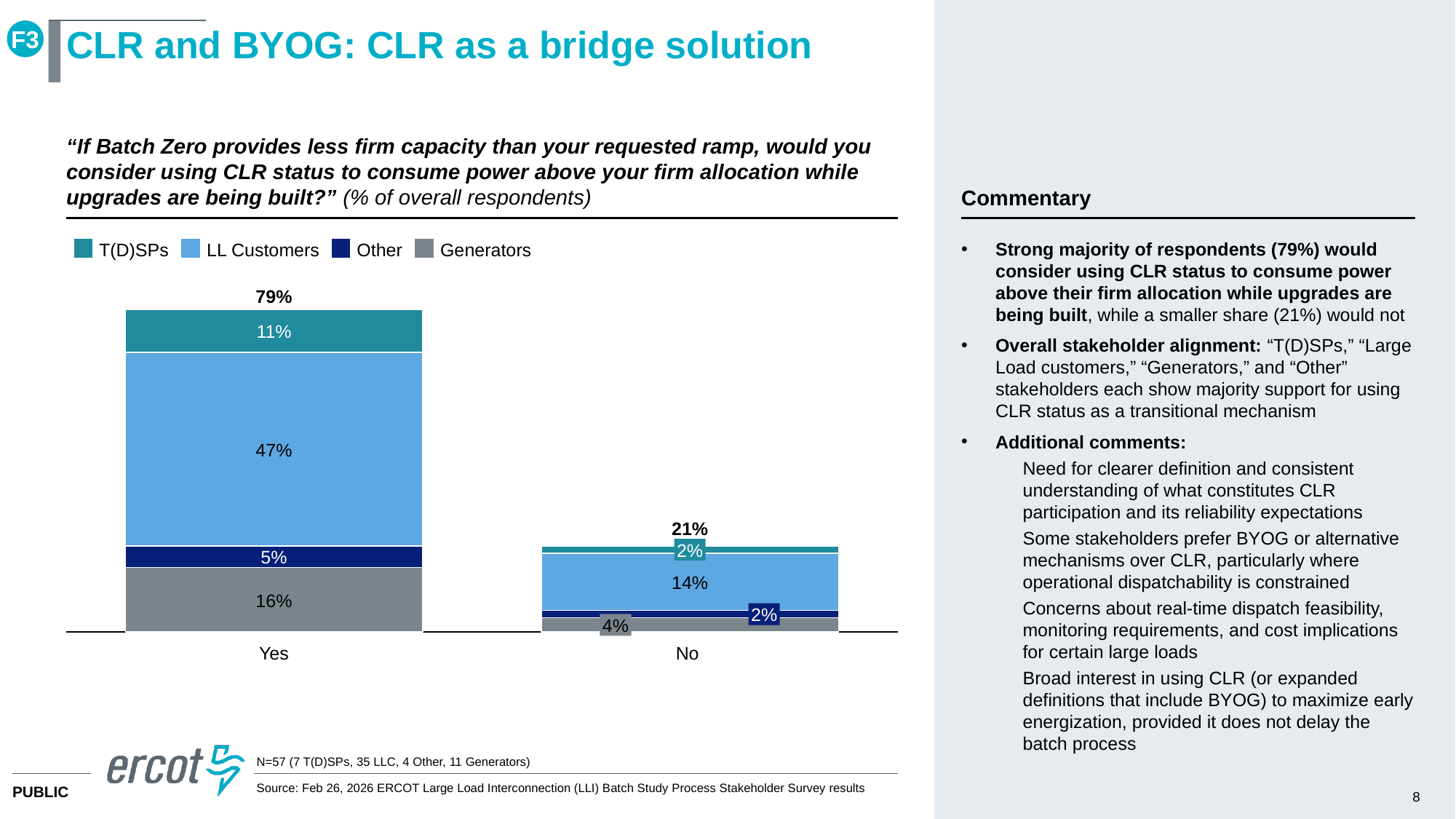
What is the difference between the Yes total and the No total? 58% How many categories are shown on the x axis? 2 What is the Generators value in the Yes bar? 16% How many series does the legend list? 4 Which category has the higher total, Yes or No? Yes What type of chart is shown on the slide? Stacked bar chart What is the total for the No bar? 21% What is the T(D)SPs value in the No bar? 2% What is the LL Customers value in the Yes bar? 47% Which series is listed first in the legend? T(D)SPs What is the total for the Yes bar? 79% What is the LL Customers value in the No bar? 14%